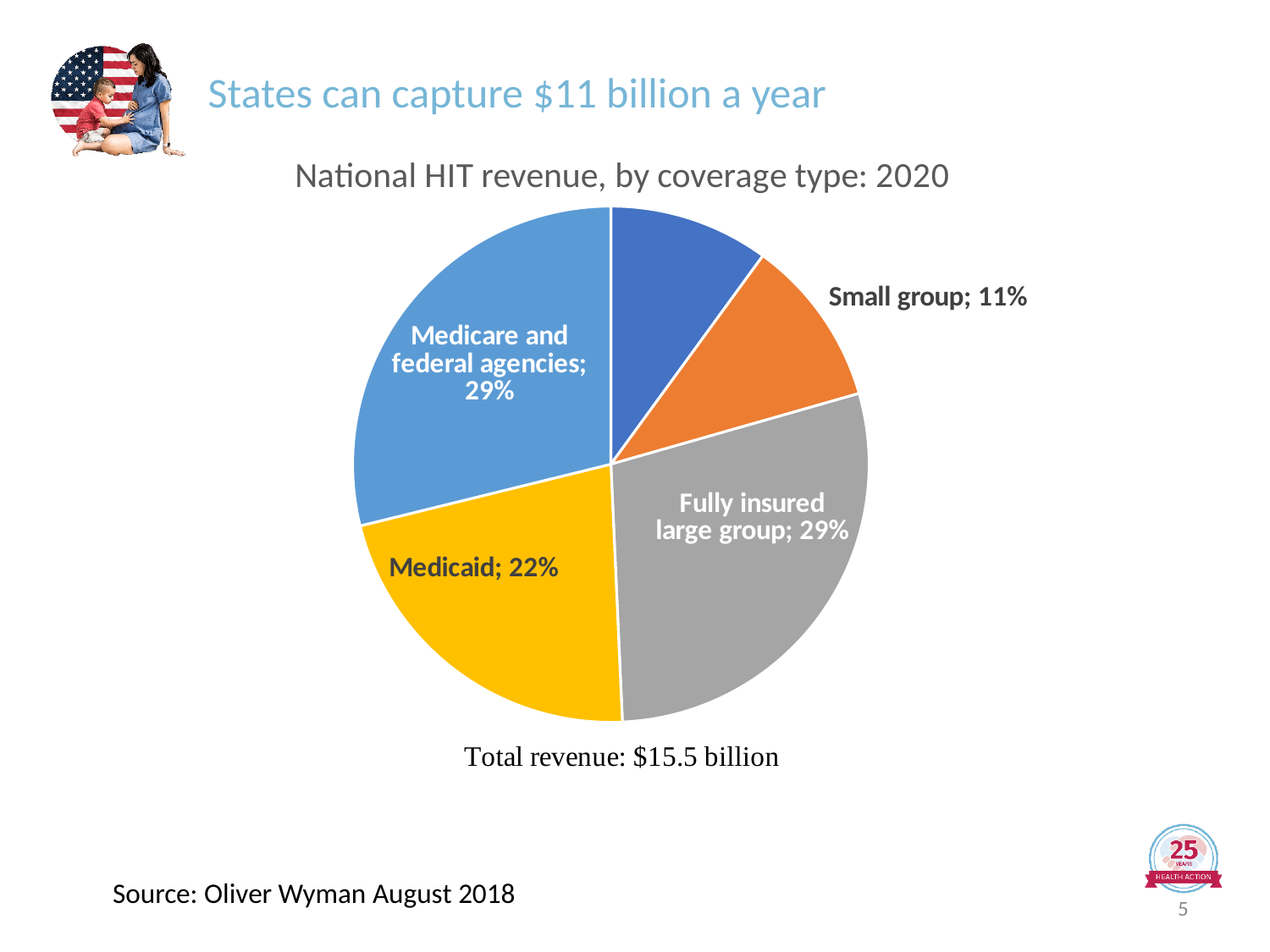
What total revenue is stated below the chart? $15.5 billion What share of national HIT revenue comes from Medicare and federal agencies? 29% What is the title of the chart? National HIT revenue, by coverage type: 2020 What share of national HIT revenue comes from Medicaid? 22% What is the difference in percentage points between the Medicaid share and the Small group share? 11 percentage points What share of national HIT revenue comes from Small group coverage? 11% How many slices does the pie chart have? 5 What is the difference in percentage points between the Fully insured large group share and the Medicaid share? 7 percentage points What kind of chart is shown on the slide? Pie chart Which is larger, the Fully insured large group share or the Medicaid share? Fully insured large group Which is larger, the Medicaid share or the Small group share? Medicaid